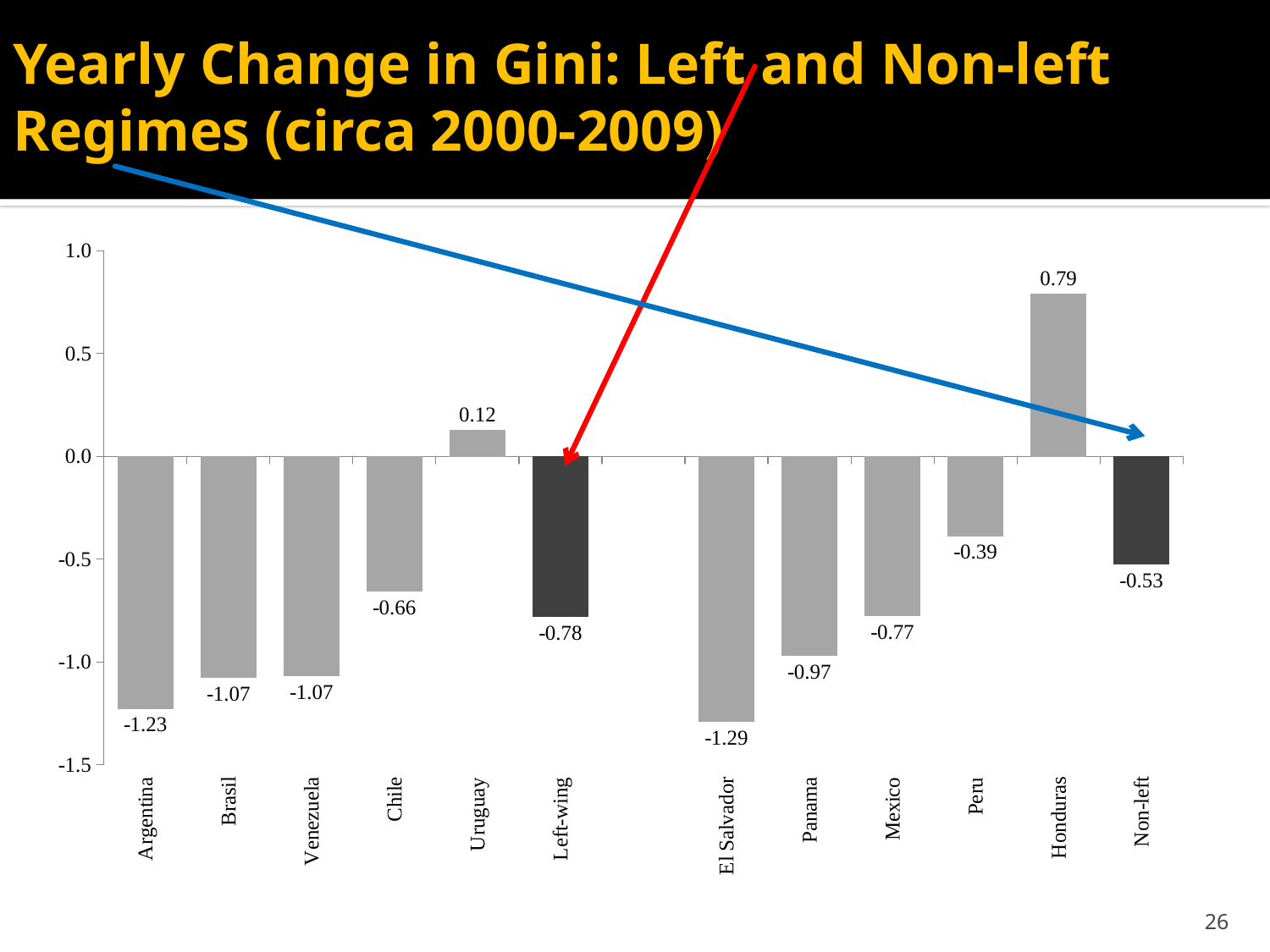
What is the title of the slide? Yearly Change in Gini: Left and Non-left Regimes (circa 2000-2009) Which is larger, the value for Chile or the value for Mexico? Chile Is the value for Panama greater or less than -0.5? less How many categories are shown on the x axis? 12 What is the value shown for the Non-left bar? -0.53 Which category has the lowest value? El Salvador What kind of chart is shown on the slide? Bar chart Which category has the highest value? Honduras What is the yearly change in Gini for Argentina? -1.23 What is the value shown for Honduras? 0.79 What is the difference between the Honduras value and the Uruguay value? 0.67 What is the value shown for the Left-wing bar? -0.78